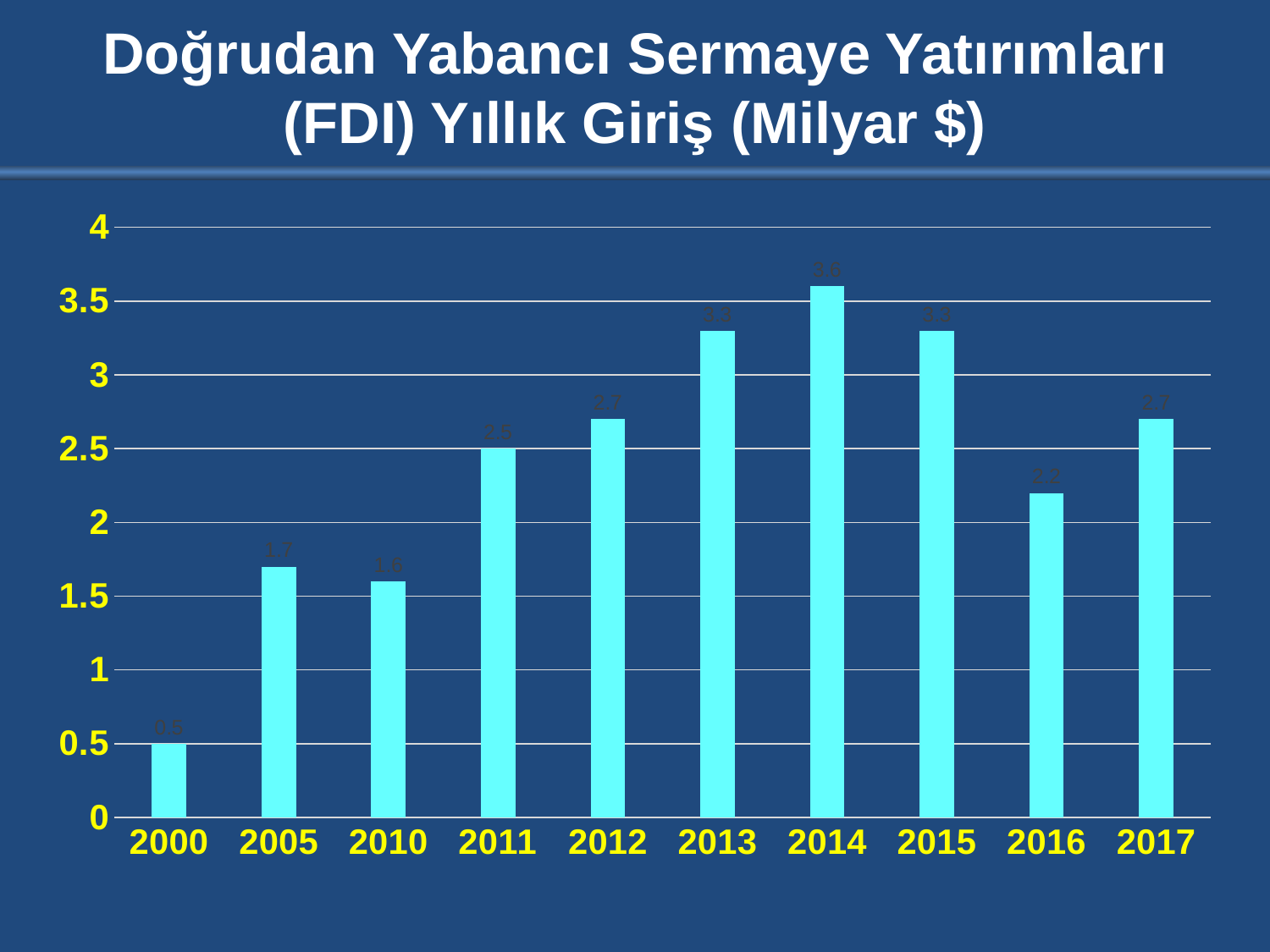
How many years are shown on the x axis of the chart? 10 What is the title of the chart on the slide? Doğrudan Yabancı Sermaye Yatırımları (FDI) Yıllık Giriş (Milyar $) What is the FDI annual inflow value for 2014? 3.6 Is the value for 2010 greater or less than 2? less Is the value for 2011 greater or less than 2? greater What is the difference between the values for 2014 and 2000? 3.1 Which year has the lowest FDI annual inflow? 2000 What type of chart is shown on the slide? bar chart What is the FDI annual inflow value for 2016? 2.2 What is the FDI annual inflow value for 2000? 0.5 Which is larger, the value for 2012 or the value for 2016? 2012 Which year has the highest FDI annual inflow? 2014